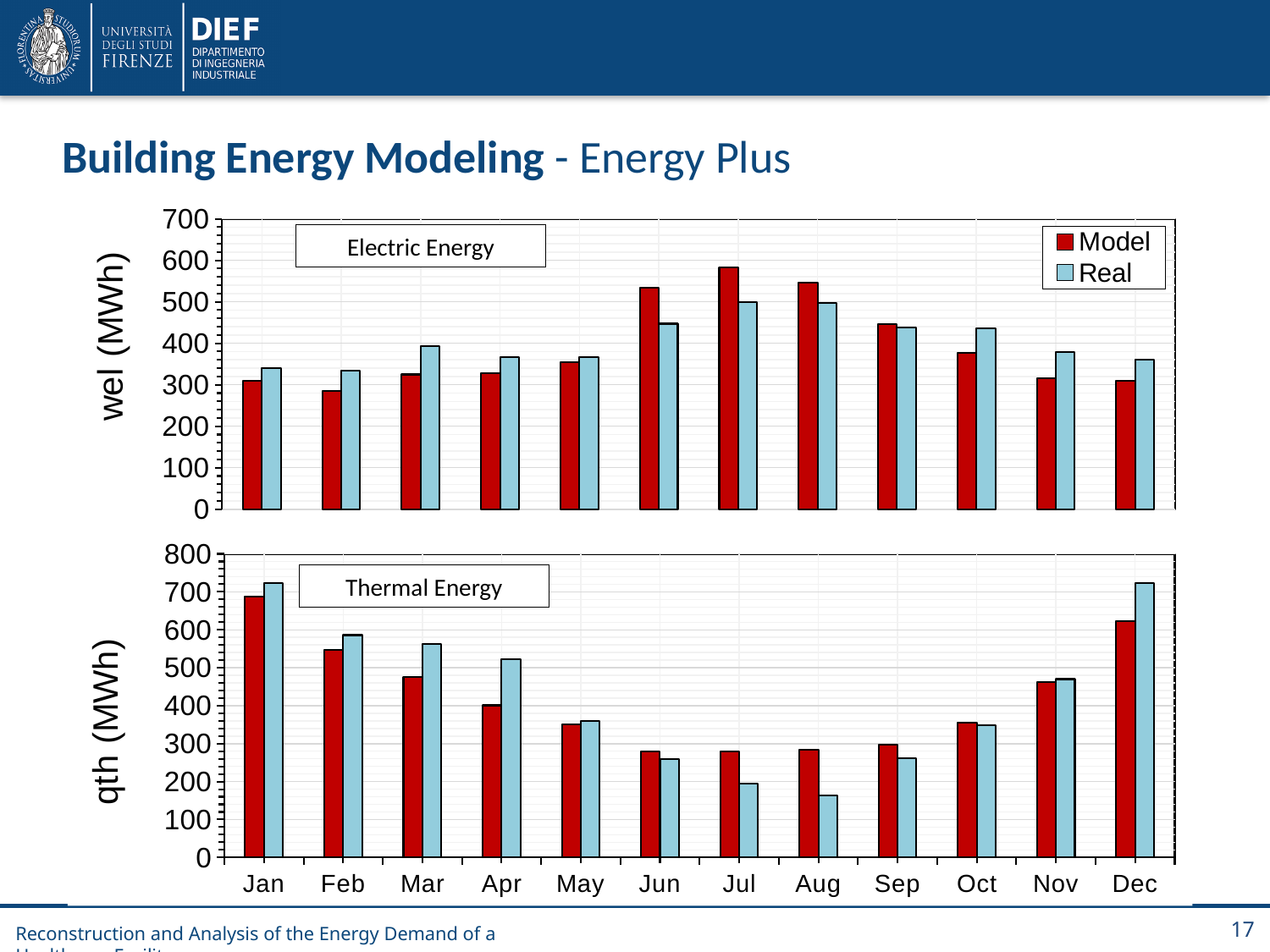
How many months are shown on the x axis of the Thermal Energy chart? 12 In the Thermal Energy chart, is the Real value for Aug greater or less than 200? less In the Thermal Energy chart, which is larger for Apr, the Model value or the Real value? Real In the Thermal Energy chart, do the Model values rise or fall from Jan to Jun? fall In the Electric Energy chart, which month has the highest Model value? Jul In the Electric Energy chart, which is larger for Jun, the Model value or the Real value? Model In the Thermal Energy chart, which month has the highest Model value? Jan In the Electric Energy chart, which month has the lowest Model value? Feb What kind of chart is the Electric Energy chart? bar chart In the Electric Energy chart, is the Model value for Jul greater or less than 500? greater In the Thermal Energy chart, which month has the lowest Real value? Aug How many series does the legend list on the Electric Energy chart? 2